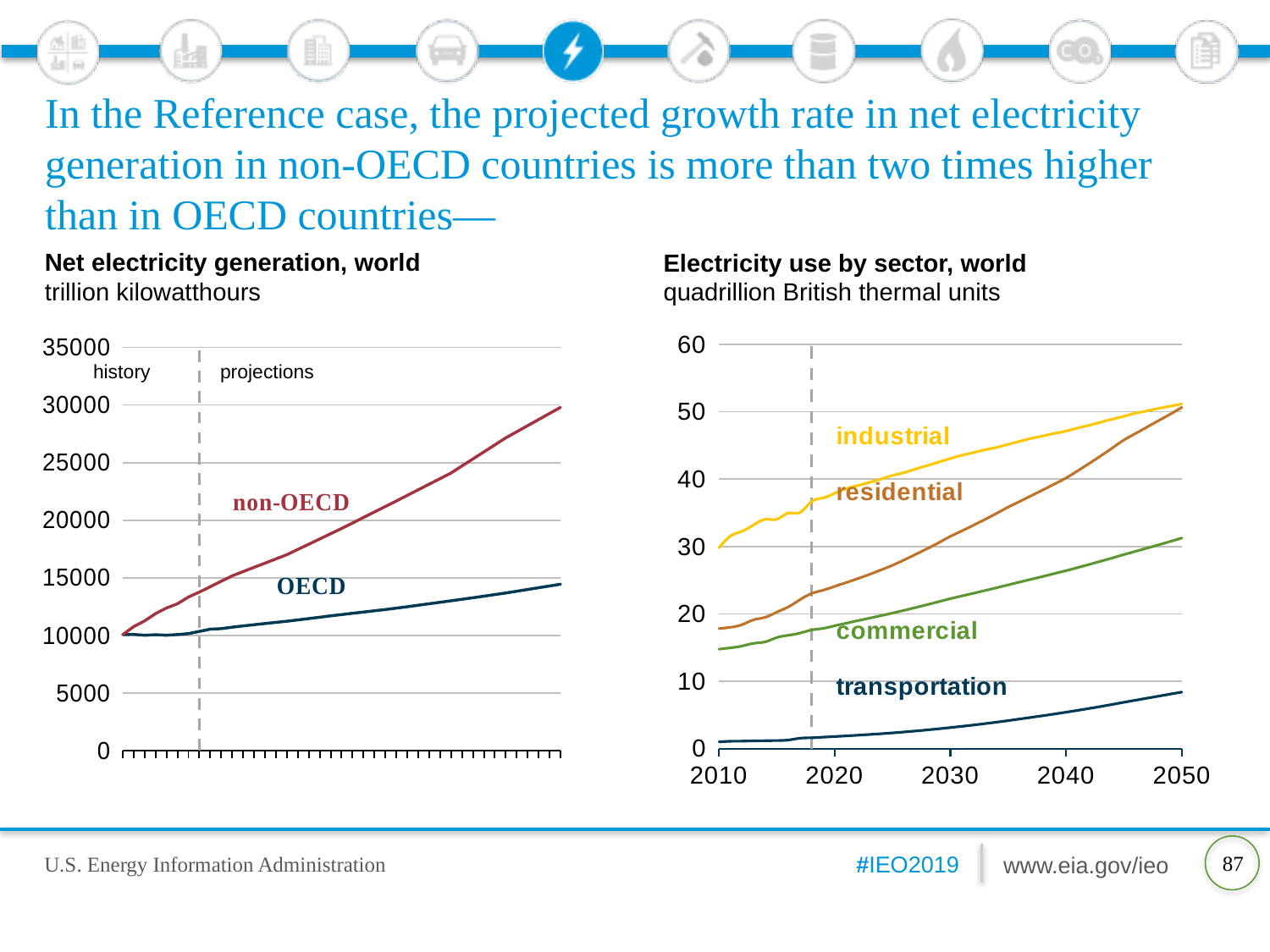
How many series are plotted on the 'Net electricity generation, world' chart? 2 On the 'Net electricity generation, world' chart, does the non-OECD series rise or fall over time? rise On the 'Electricity use by sector, world' chart, which sector has the lowest electricity use in 2050? transportation What type of chart is the 'Net electricity generation, world' chart? line chart On the 'Net electricity generation, world' chart, which series is higher at the end of the projection period? non-OECD On the 'Net electricity generation, world' chart, is the final projected value for non-OECD greater or less than 25000? greater On the 'Electricity use by sector, world' chart, is the value for transportation in 2050 greater or less than 10? less On the 'Electricity use by sector, world' chart, which sector has the highest electricity use in 2010? industrial On the 'Electricity use by sector, world' chart, is the value for commercial in 2050 greater or less than 20? greater How many sectors are plotted on the 'Electricity use by sector, world' chart? 4 What unit is used on the 'Net electricity generation, world' chart? trillion kilowatthours